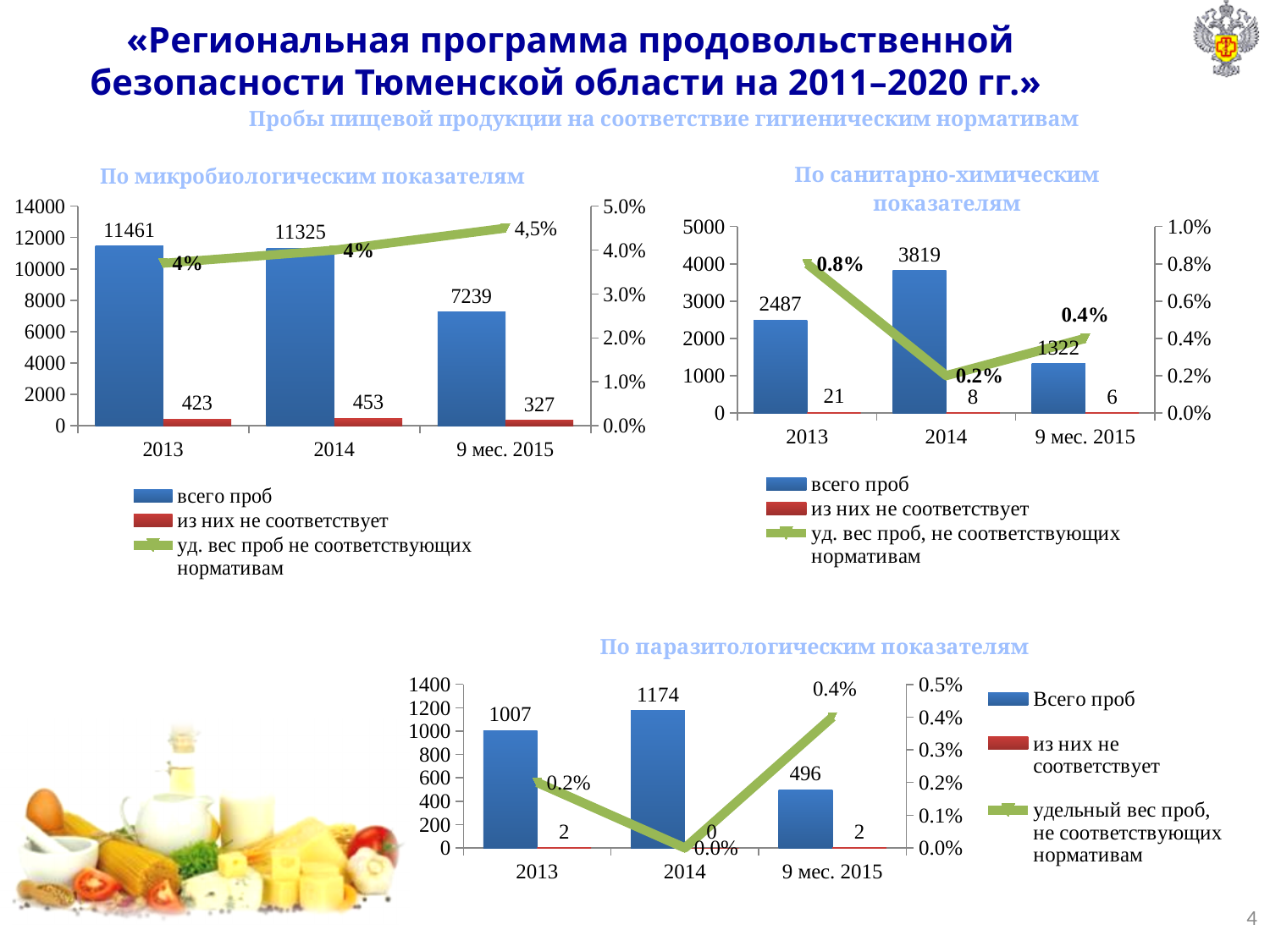
In the chart «По паразитологическим показателям», what is the value of «Всего проб» for 2014? 1174 In the chart «По паразитологическим показателям», what is the share of non-conforming samples for 9 мес. 2015? 0.4% In the chart «По микробиологическим показателям», what is the value of «из них не соответствует» for 2014? 453 How many categories are shown on the x axis of the chart «По санитарно-химическим показателям»? 3 In the chart «По микробиологическим показателям», what is the value of «всего проб» for 2013? 11461 In the chart «По микробиологическим показателям», what is the share of non-conforming samples (уд. вес) for 9 мес. 2015? 4,5% In the chart «По микробиологическим показателям», what is the difference between «всего проб» in 2013 and 2014? 136 In the chart «По микробиологическим показателям», which category has the lowest value of «всего проб»? 9 мес. 2015 In the chart «По санитарно-химическим показателям», what is the value of «всего проб» for 2014? 3819 In the chart «По санитарно-химическим показателям», what is the value of «из них не соответствует» for 9 мес. 2015? 6 In the chart «По санитарно-химическим показателям», which category has the highest share of non-conforming samples (уд. вес)? 2013 In the chart «По паразитологическим показателям», how many series does the legend list? 3